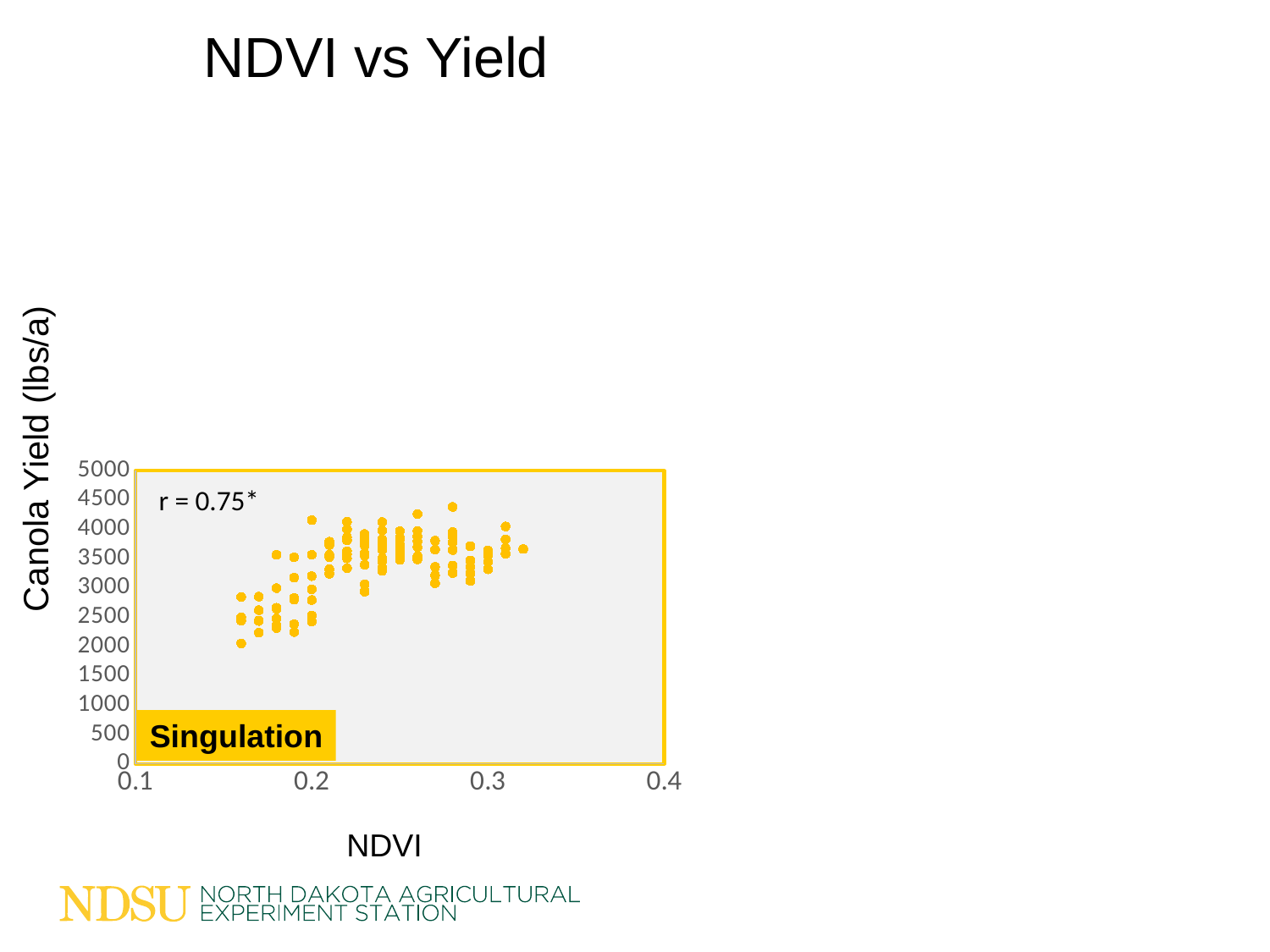
As NDVI increases along the x axis, does canola yield generally rise or fall? Rise What correlation coefficient is printed on the chart? r = 0.75* What kind of chart is shown on the slide? Scatter plot Is the highest canola yield plotted greater or less than 4500 lbs/a? less Are the points at NDVI around 0.16 mostly above or below 3000 lbs/a? below What is the label on the y axis of the chart? Canola Yield (lbs/a) Is the largest NDVI value plotted greater or less than 0.4? less